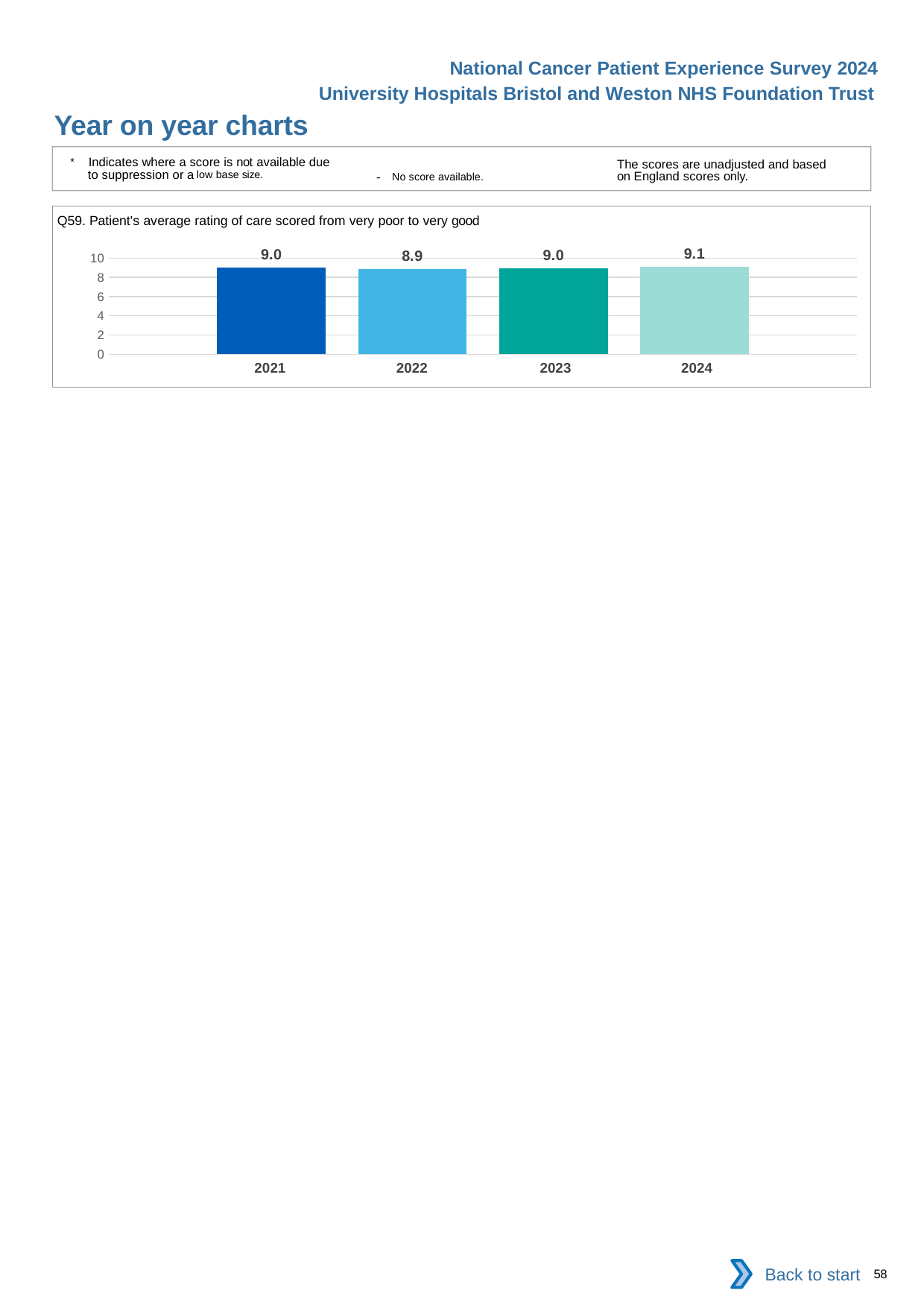
Which year has the highest value in the Q59 chart? 2024 What is the value for 2023 in the Q59 chart? 9.0 Is the value for 2023 greater or less than 8 in the Q59 chart? greater How many years are shown in the Q59 chart? 4 What is the title of the chart on the slide? Q59. Patient's average rating of care scored from very poor to very good What is the difference between the 2024 and 2022 values in the Q59 chart? 0.2 Which year has the lowest value in the Q59 chart? 2022 What is the value for 2024 in the Q59 chart? 9.1 What is the value for 2021 in the Q59 chart? 9.0 Is the value for 2022 or 2024 larger in the Q59 chart? 2024 What is the value for 2022 in the Q59 chart? 8.9 What kind of chart is used for Q59? Bar chart